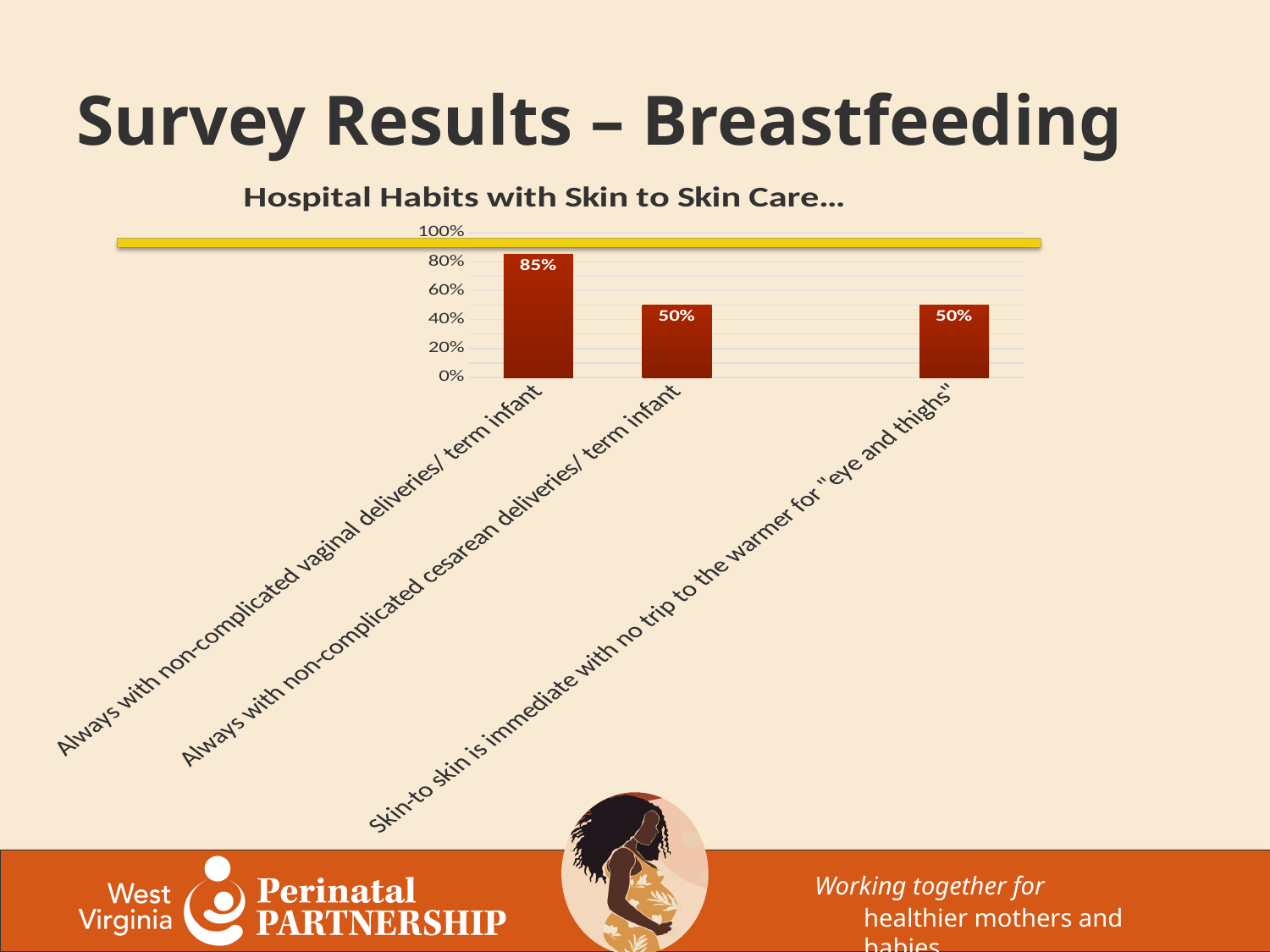
Which is larger: the value for non-complicated vaginal deliveries or the value for non-complicated cesarean deliveries? Always with non-complicated vaginal deliveries/ term infant Which category has the highest value? Always with non-complicated vaginal deliveries/ term infant What is the value for "Always with non-complicated vaginal deliveries/ term infant"? 85% What is the title of the chart? Hospital Habits with Skin to Skin Care... What is the value for "Always with non-complicated cesarean deliveries/ term infant"? 50% What kind of chart is shown on the slide? Bar chart Is the value for "Always with non-complicated vaginal deliveries/ term infant" greater or less than 60%? greater What is the difference between the value for non-complicated vaginal deliveries and the value for non-complicated cesarean deliveries? 35% How many categories are shown in the chart? 3 What is the highest value shown on the vertical axis? 100% Is the value for "Always with non-complicated cesarean deliveries/ term infant" greater or less than 80%? less What is the value for "Skin-to skin is immediate with no trip to the warmer for "eye and thighs""? 50%